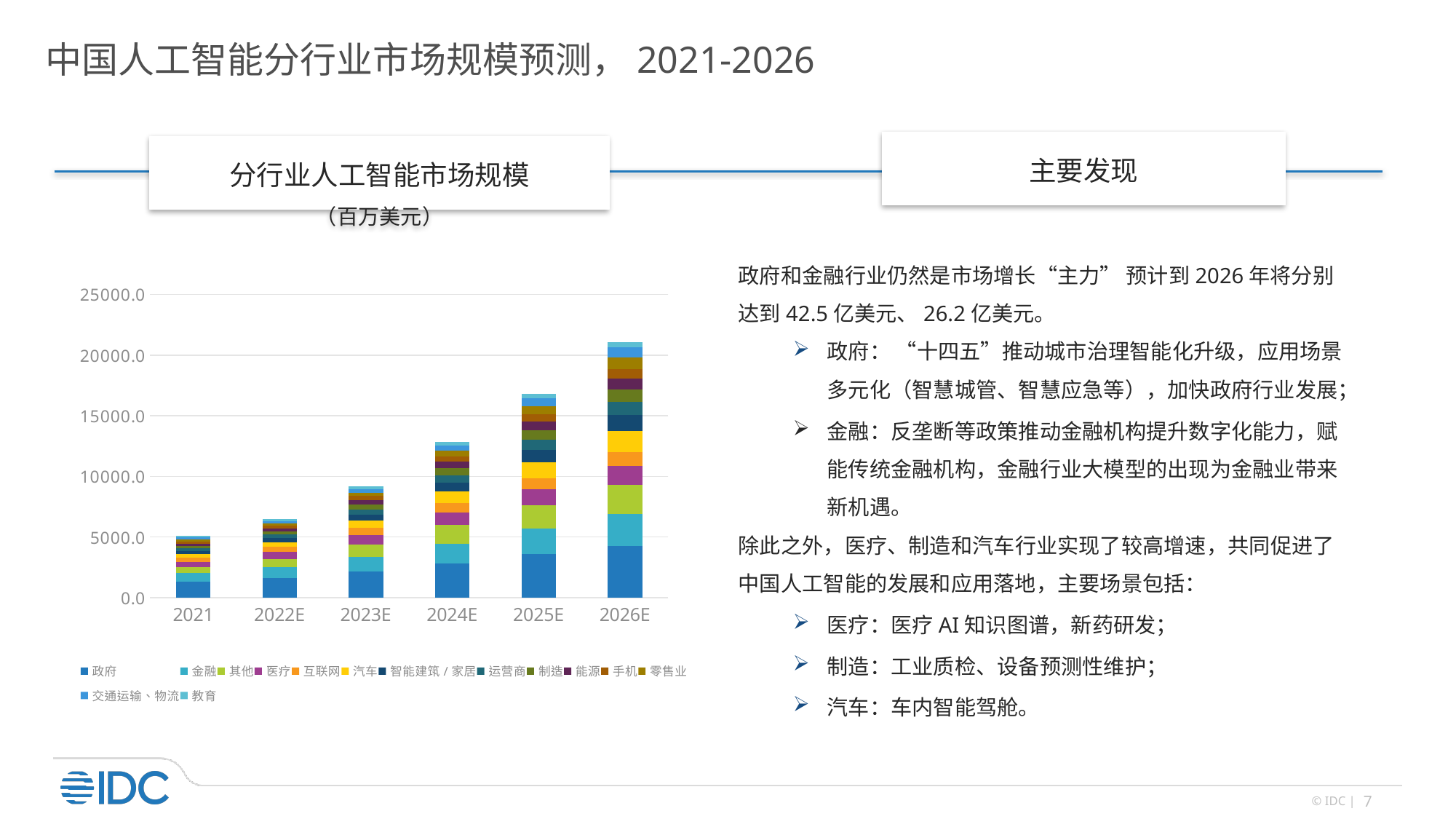
Do the total bar heights rise or fall from 2021 to 2026E? Rise What kind of chart is shown on the slide? Stacked bar chart How many years (categories) are shown on the x axis of the chart? 6 What unit is stated under the chart's title? 百万美元 Which year has the shortest stacked bar in the chart? 2021 Is the total stacked value for 2025E greater or less than 15000.0? greater Is the total stacked value for 2023E greater or less than 10000.0? less How many series does the chart's legend list? 14 Which year has the tallest stacked bar in the chart? 2026E Is the total stacked value for 2026E greater or less than 20000.0? greater Which series is listed first in the chart's legend? 政府 Which has the larger total stacked bar, 2024E or 2025E? 2025E